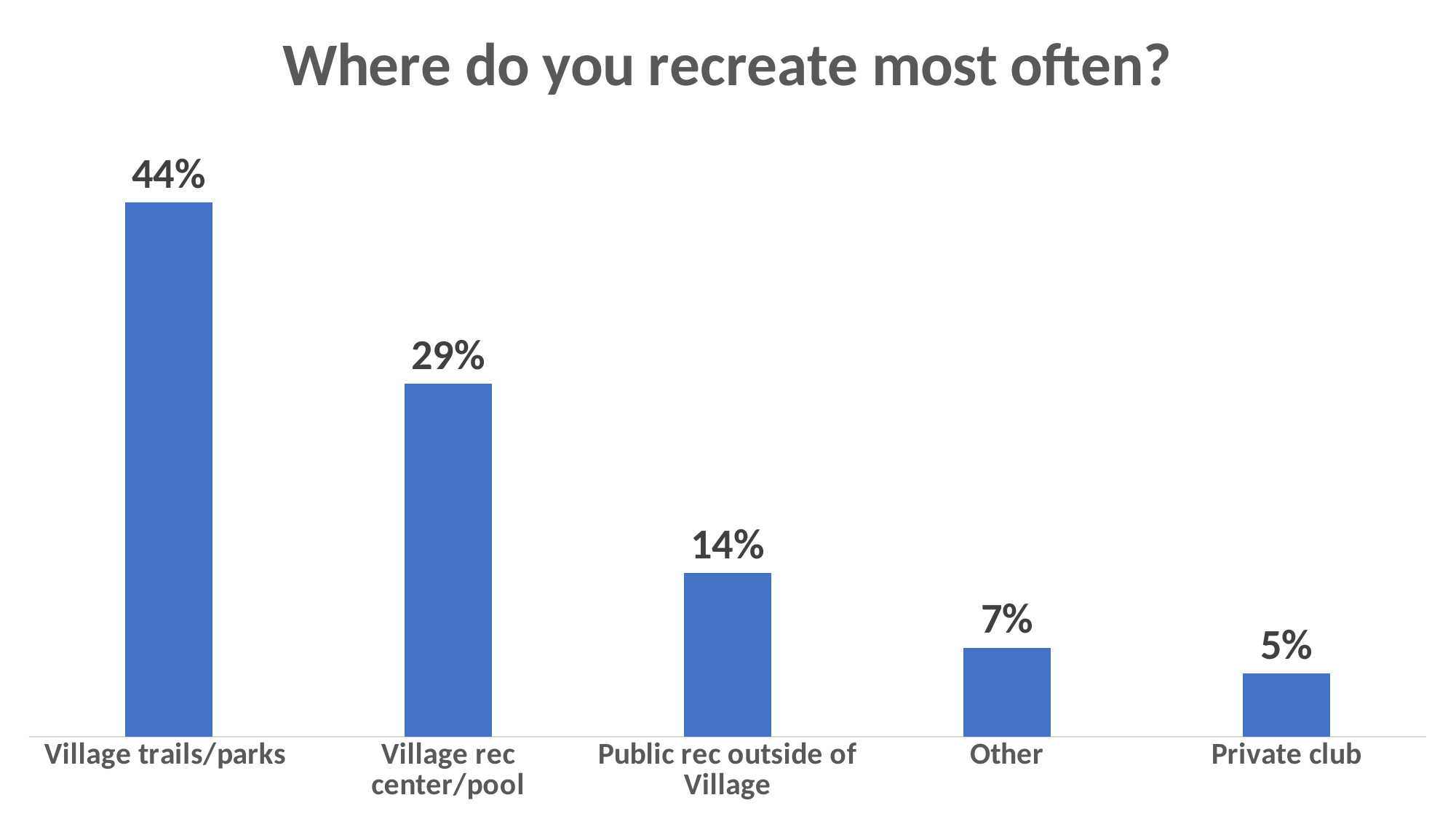
What is the title of the chart? Where do you recreate most often? How many categories are shown in the chart? 5 What percentage is shown for Public rec outside of Village? 14% Which is larger, the value for Public rec outside of Village or the value for Other? Public rec outside of Village What is the value for Private club? 5% What kind of chart is shown on the slide? Bar chart Which category has the highest value? Village trails/parks What is the value shown for Village rec center/pool? 29% What is the difference between the values for Other and Private club? 2% What is the difference between the values for Village trails/parks and Village rec center/pool? 15% What percentage of respondents recreate most often at Village trails/parks? 44% Which category has the lowest value? Private club